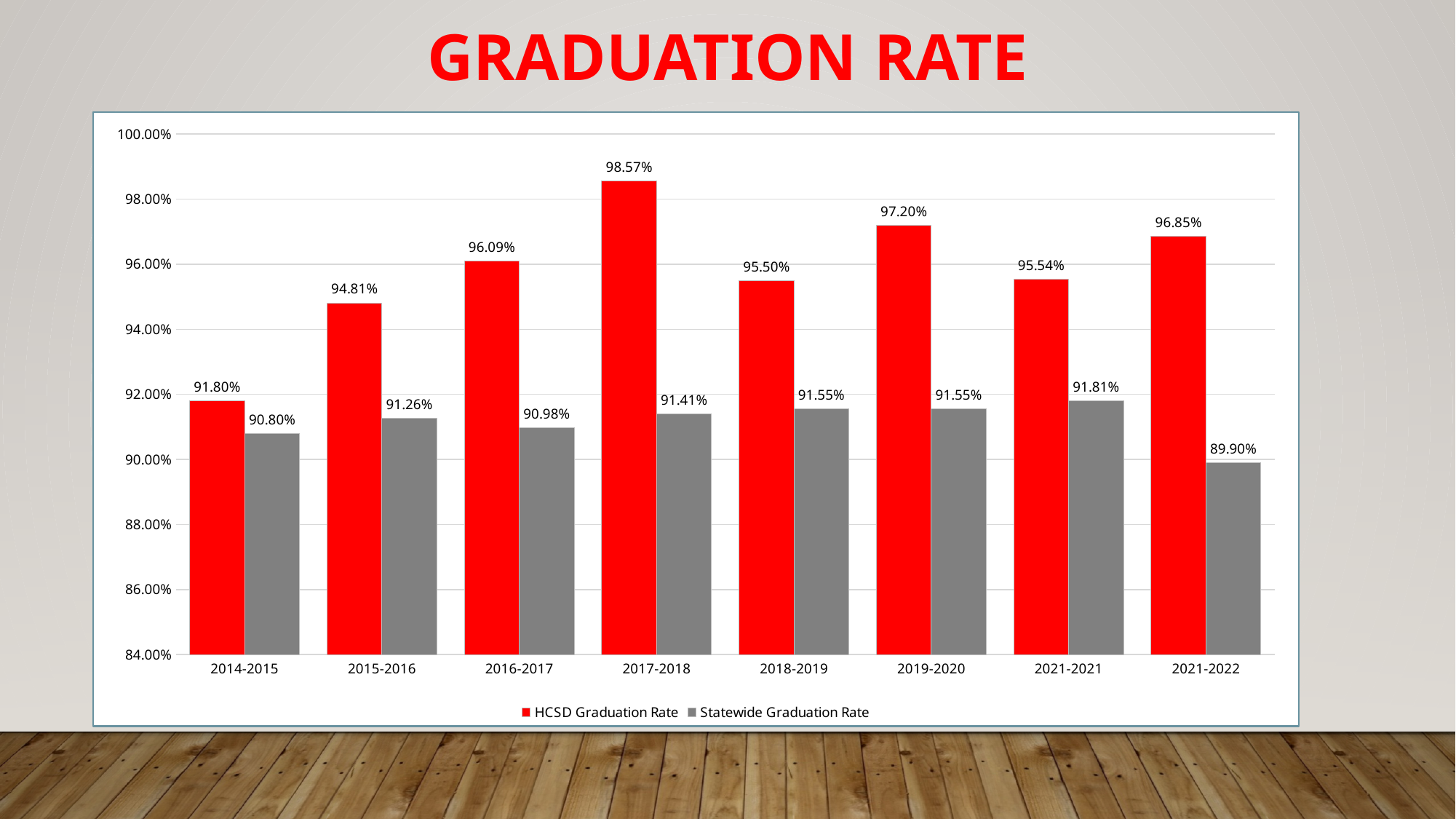
In which school year is the HCSD Graduation Rate lowest? 2014-2015 What is the difference between the HCSD Graduation Rate and the Statewide Graduation Rate in 2017-2018? 7.16% In which school year is the HCSD Graduation Rate highest? 2017-2018 What is the Statewide Graduation Rate for 2021-2022? 89.90% By how much did the HCSD Graduation Rate change from 2021-2021 to 2021-2022? 1.31% How many series does the legend list? 2 Which is larger in 2014-2015, the HCSD Graduation Rate or the Statewide Graduation Rate? HCSD Graduation Rate Is the HCSD Graduation Rate for 2015-2016 greater or less than 94.00%? greater How many school years are shown on the x axis? 8 What is the HCSD Graduation Rate for 2017-2018? 98.57% What kind of chart is shown on the slide? bar chart In which school year is the Statewide Graduation Rate lowest? 2021-2022